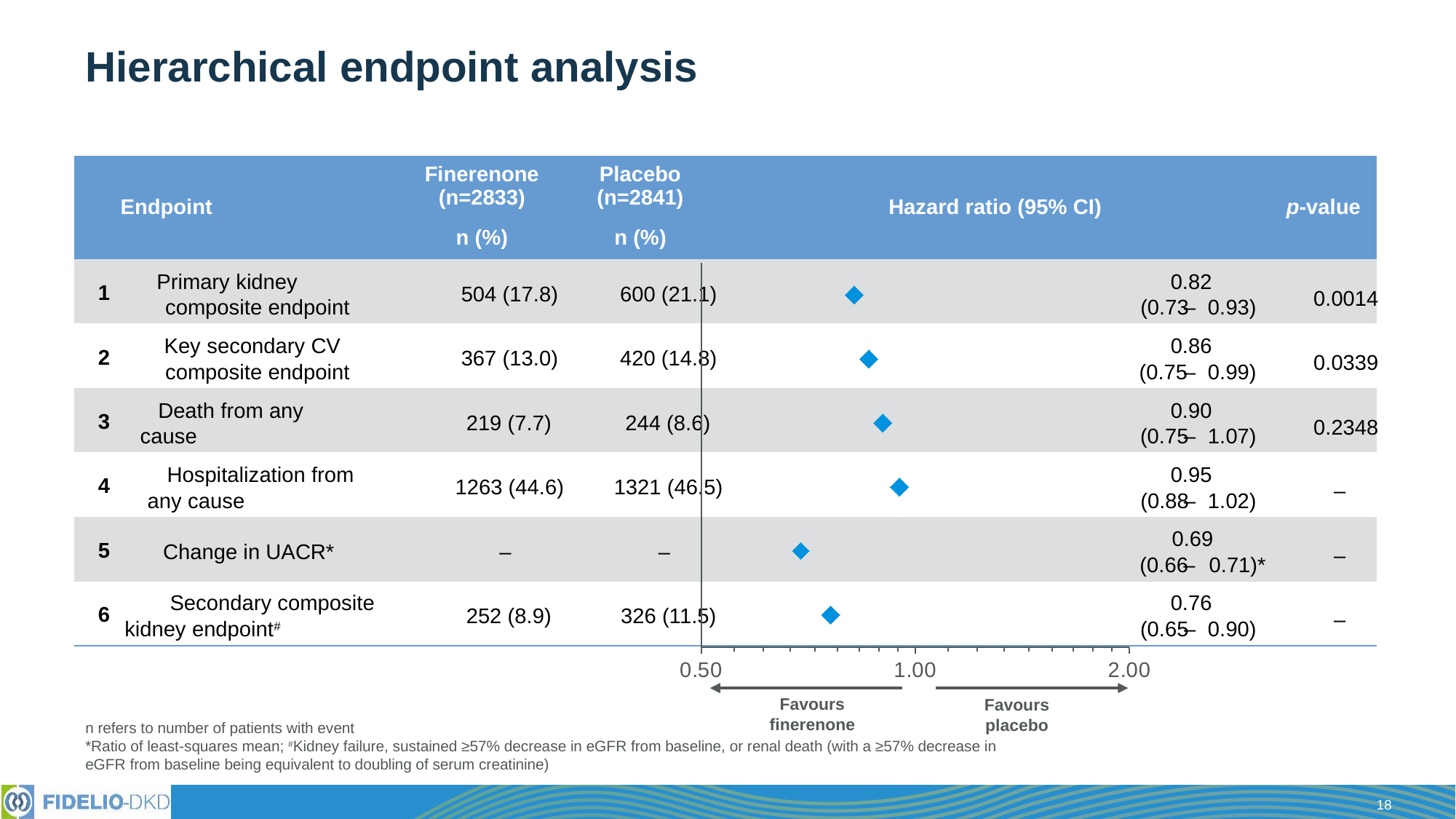
Which has the larger hazard ratio: the primary kidney composite endpoint or death from any cause? Death from any cause What does the left side of the hazard ratio axis favour, according to the label below the chart? Favours finerenone What is the hazard ratio for the primary kidney composite endpoint? 0.82 What kind of chart is used to display the hazard ratios? Forest plot What is the hazard ratio for the secondary composite kidney endpoint? 0.76 Which endpoint has the lowest hazard ratio? Change in UACR Is the hazard ratio for the key secondary CV composite endpoint greater or less than 1.00? less What is the difference between the hazard ratio for hospitalization from any cause and the hazard ratio for change in UACR? 0.26 How many endpoints are plotted in the hazard ratio chart? 6 Which endpoint has the highest hazard ratio? Hospitalization from any cause What is the hazard ratio for change in UACR? 0.69 What is the p-value for the primary kidney composite endpoint? 0.0014